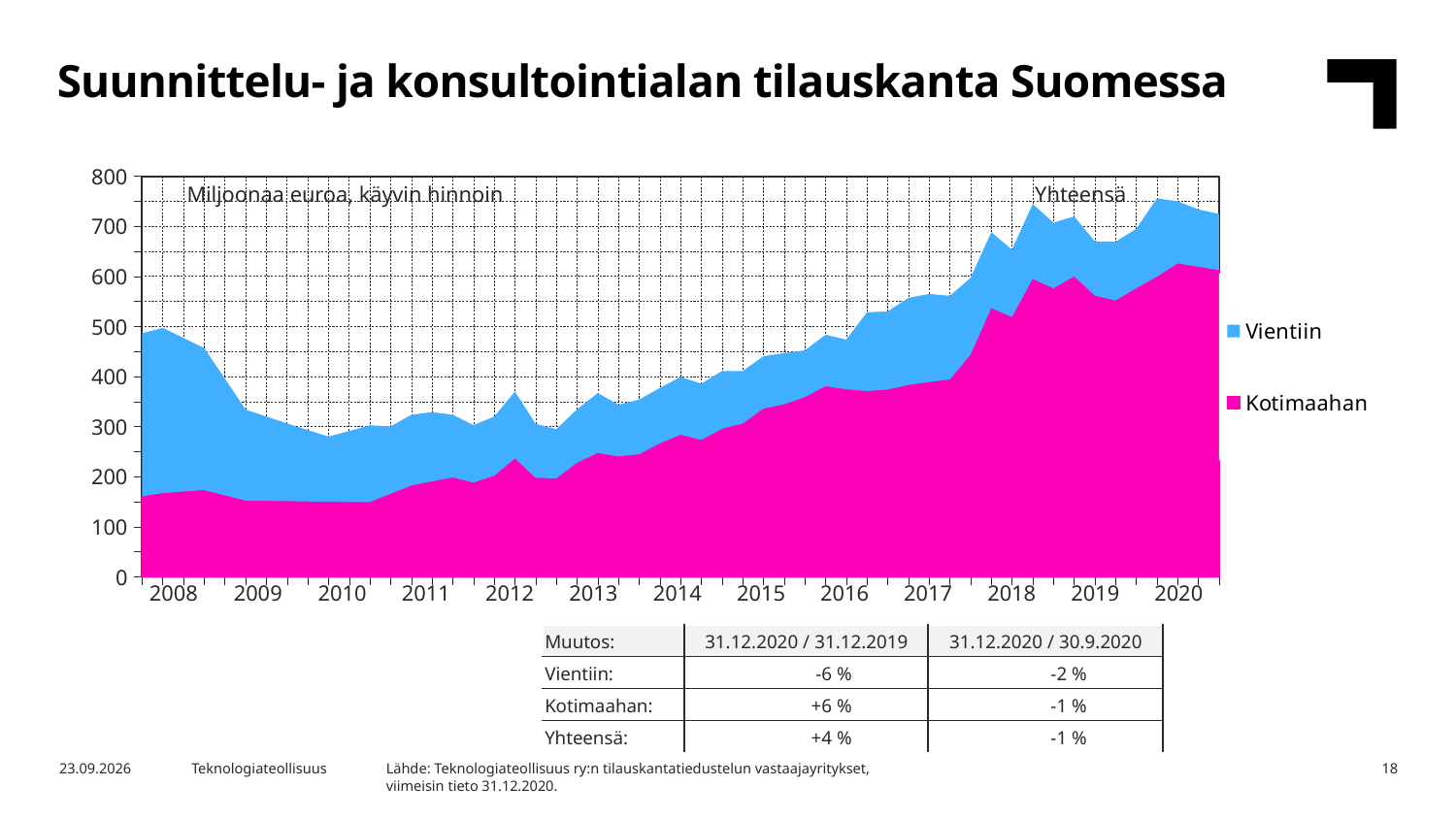
Is the value for Kotimaahan at the end of 2020 greater or less than 500? greater Which two series are listed in the chart legend? Vientiin and Kotimaahan What unit is stated in the chart for the values? Miljoonaa euroa, käyvin hinnoin What kind of chart is shown on the slide? Stacked area chart In 2020, which series is larger, Vientiin or Kotimaahan? Kotimaahan At the start of 2008, which series is larger, Vientiin or Kotimaahan? Vientiin Is the total (Yhteensä) value in 2010 greater or less than 400? less How many series does the chart legend list? 2 How many years are labelled on the x axis of the chart? 13 Does the Kotimaahan series rise or fall from 2017 to 2020? Rises Does the total order backlog (Yhteensä) rise or fall from 2008 to 2010? Falls Is the value for Kotimaahan at the start of 2008 greater or less than 200? less